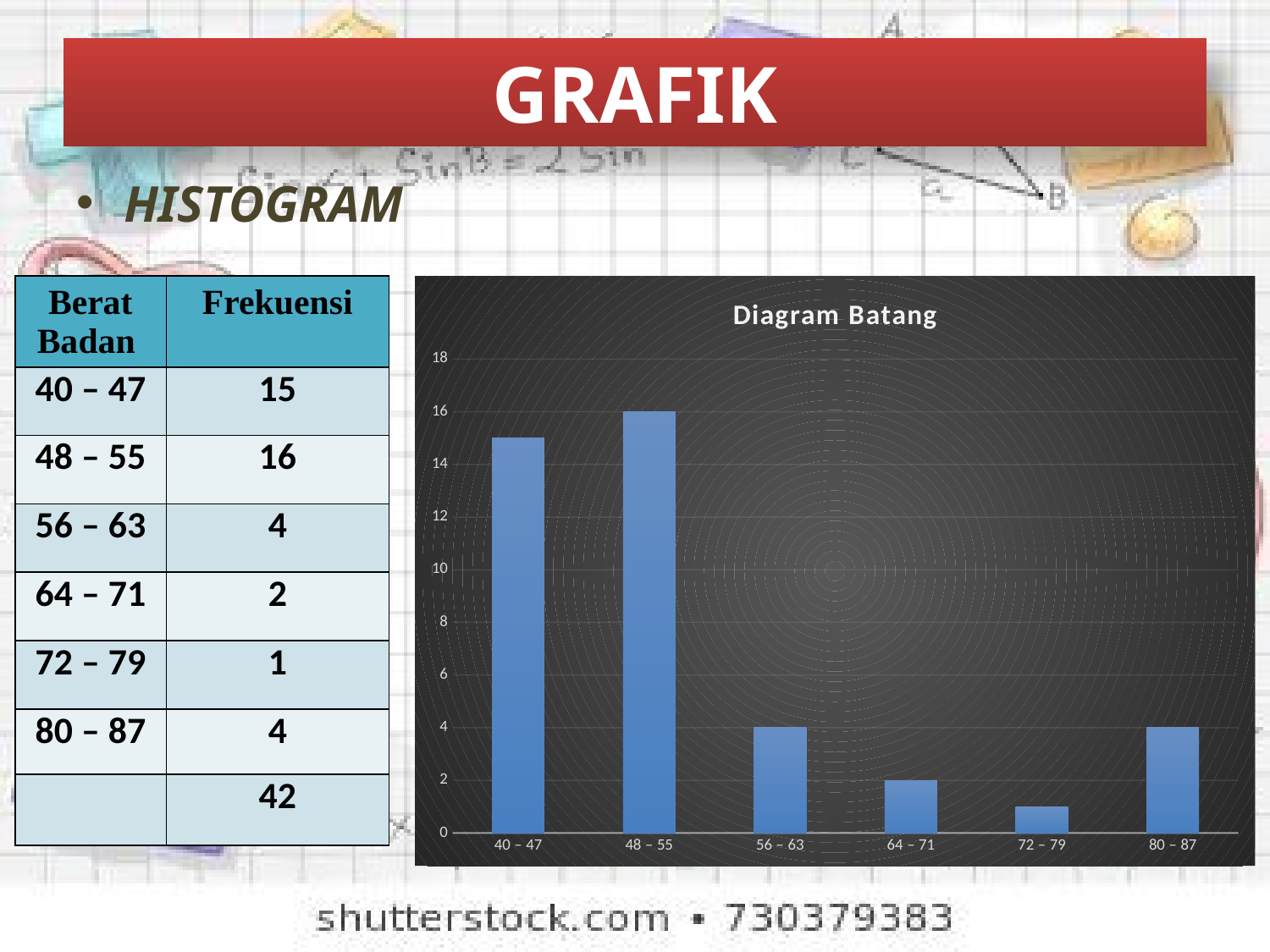
What is the value for the 40 – 47 category? 15 Is the value for 40 – 47 greater or less than 14? greater What kind of chart is shown on the slide? bar chart Which category has the highest bar in the chart? 48 – 55 How many categories are shown on the x axis of the chart? 6 Which is larger, the value for 56 – 63 or the value for 64 – 71? 56 – 63 What is the title of the chart? Diagram Batang What is the value for the 48 – 55 category? 16 What is the value for the 56 – 63 category? 4 What is the value for the 64 – 71 category? 2 Which category has the lowest bar in the chart? 72 – 79 What is the difference between the value for 48 – 55 and the value for 56 – 63? 12